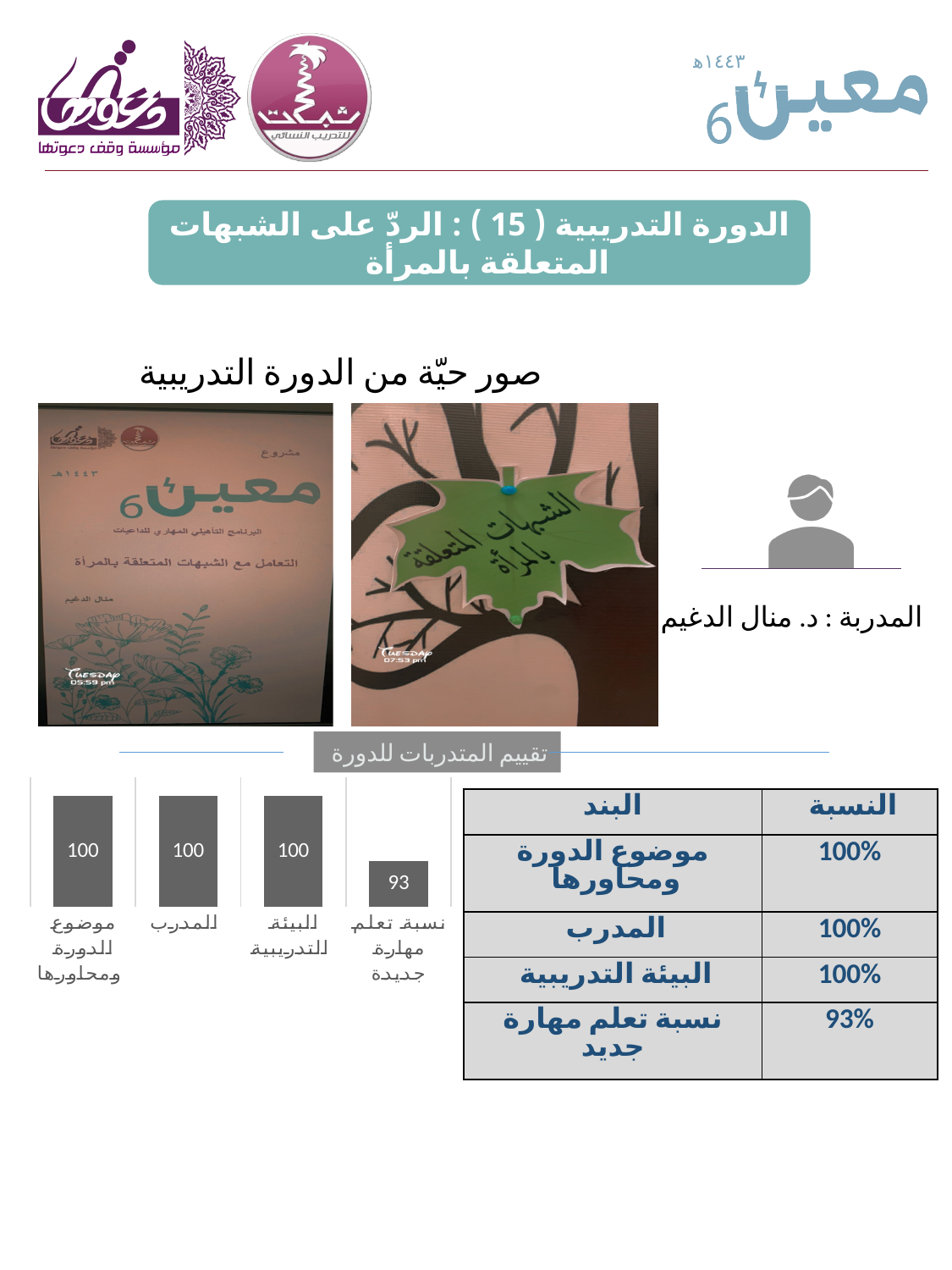
How many categories in the bar chart have a value of 100? 3 What value does the bar chart show for المدرب? 100 What value does the bar chart show for نسبة تعلم مهارة جديدة? 93 What is the heading shown above the bar chart? تقييم المتدربات للدورة How many categories are shown in the bar chart? 4 What value does the bar chart show for موضوع الدورة ومحاورها? 100 What value does the bar chart show for البيئة التدريبية? 100 Which category has the lowest value in the bar chart? نسبة تعلم مهارة جديدة What kind of chart is shown on the slide? bar chart What is the difference between the value for المدرب and the value for نسبة تعلم مهارة جديدة in the bar chart? 7 What colour are the bars in the bar chart? grey In the bar chart, which is larger: the value for البيئة التدريبية or the value for نسبة تعلم مهارة جديدة? البيئة التدريبية